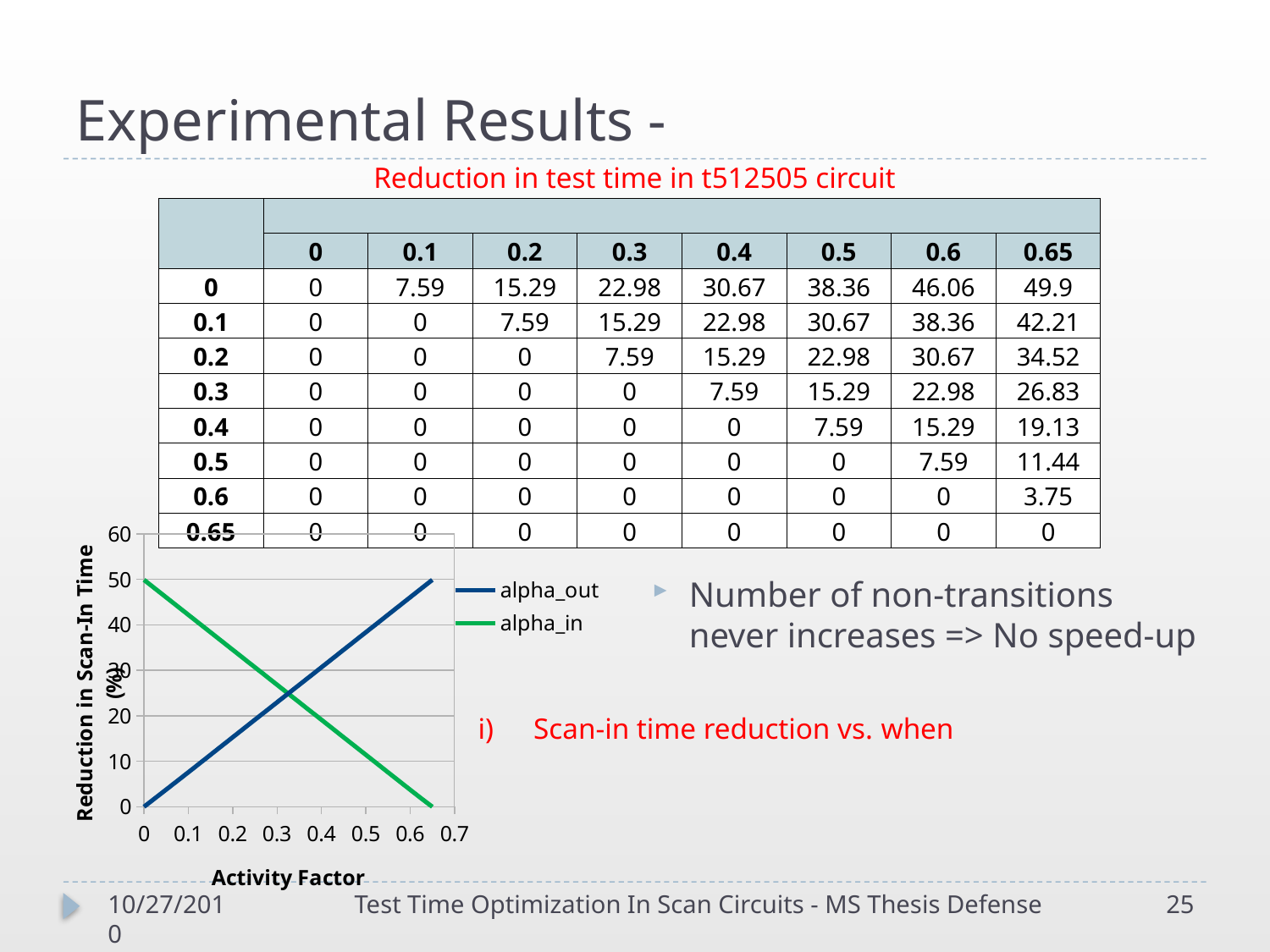
What kind of chart is shown on the slide? line chart Does the alpha_in series rise or fall as the activity factor increases? falls At an activity factor of 0.1, which series has the larger value, alpha_in or alpha_out? alpha_in Is the value of alpha_out at an activity factor of 0.6 greater or less than 40? greater Which series is drawn in green in the chart? alpha_in What is the value of alpha_out at an activity factor of 0? 0 Is the value of alpha_out at an activity factor of 0.2 greater or less than 20? less At an activity factor of 0.5, which series has the larger value, alpha_in or alpha_out? alpha_out Is the value of alpha_in at an activity factor of 0.5 greater or less than 20? less How many series does the chart legend list? 2 Does the alpha_out series rise or fall as the activity factor increases? rises What is the title of the chart's x axis? Activity Factor